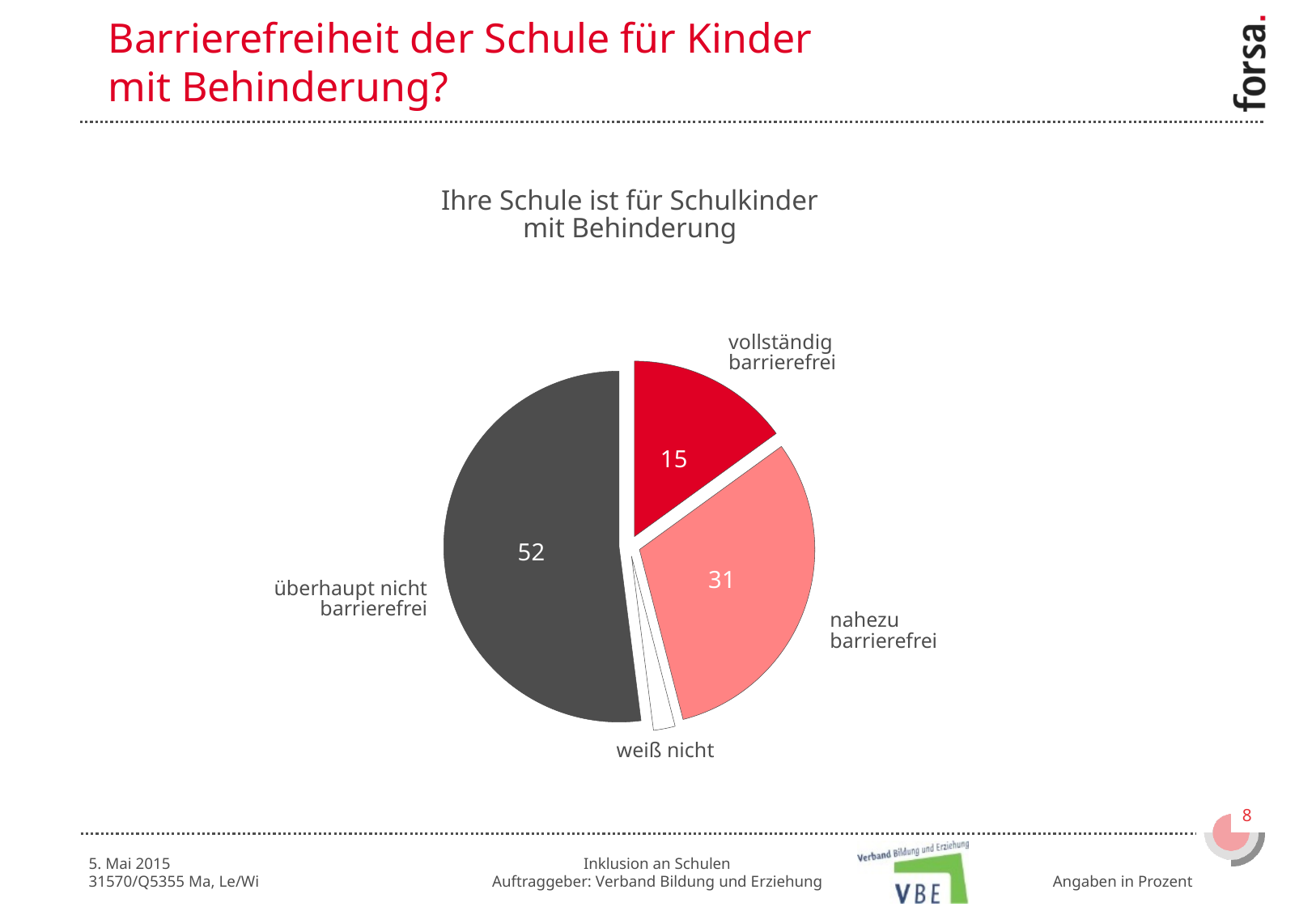
What is the difference between "nahezu barrierefrei" and "vollständig barrierefrei"? 16 Which category has the smallest slice of the pie? weiß nicht What is the title of the pie chart? Ihre Schule ist für Schulkinder mit Behinderung What is the value for "überhaupt nicht barrierefrei"? 52 What kind of chart is shown on the slide? pie chart What is the value for "vollständig barrierefrei"? 15 What is the difference between "überhaupt nicht barrierefrei" and "nahezu barrierefrei"? 21 How many slices does the pie chart have? 4 Which category has the largest slice of the pie? überhaupt nicht barrierefrei What share of the pie does "überhaupt nicht barrierefrei" represent, in percent? 52 Which is larger, "nahezu barrierefrei" or "vollständig barrierefrei"? nahezu barrierefrei What is the value for "nahezu barrierefrei"? 31